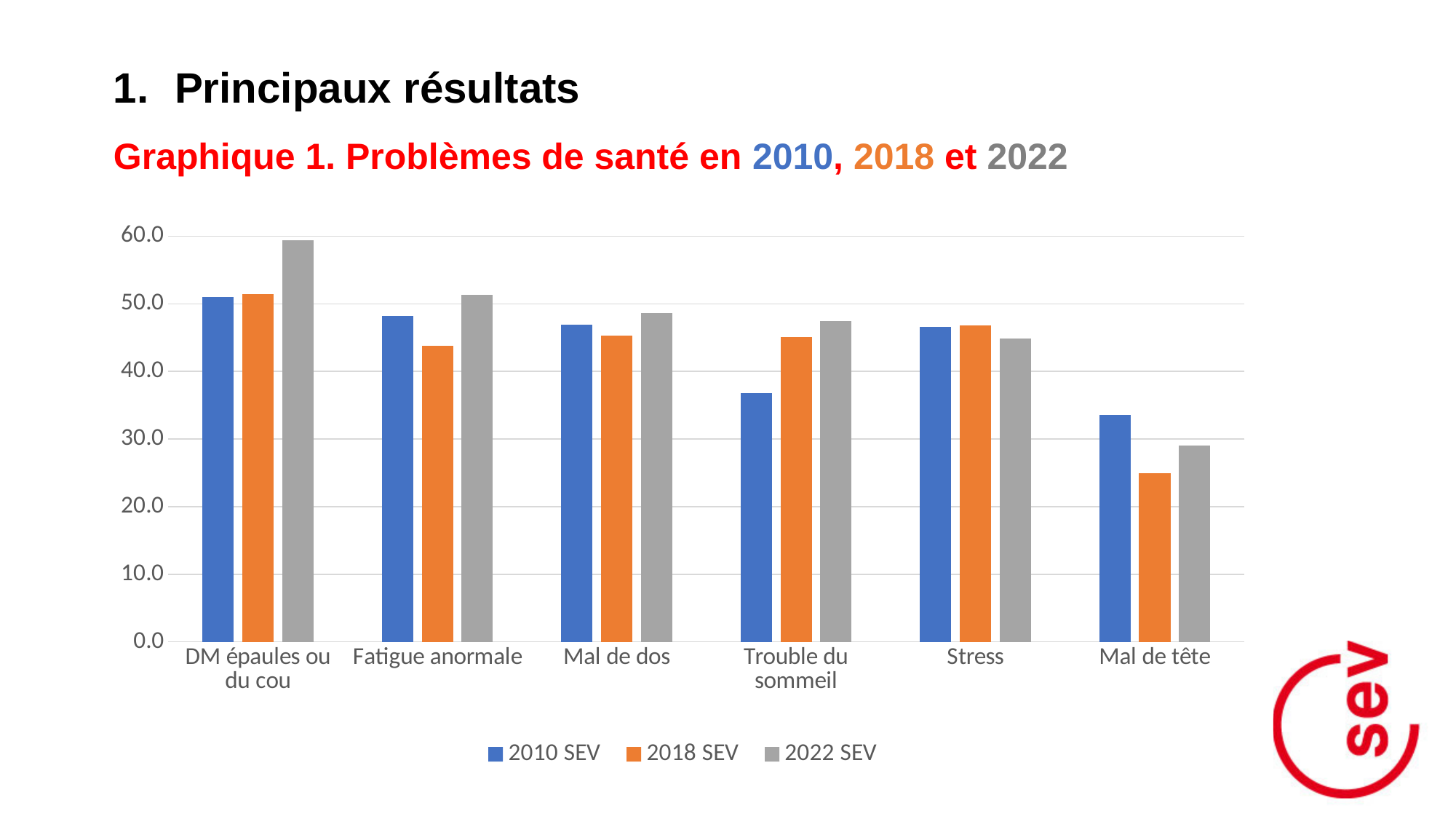
Is the 2010 SEV value for Trouble du sommeil greater or less than 40.0? less Which category has the lowest value for the 2010 SEV series? Mal de tête What colour represents the 2018 SEV series in the chart? orange Is the 2022 SEV value for DM épaules ou du cou greater or less than 50.0? greater How many health problem categories are shown on the x axis? 6 Which category has the highest value for the 2022 SEV series? DM épaules ou du cou What kind of chart is shown on the slide? bar chart How many series does the legend list? 3 Is the 2018 SEV value for Mal de tête greater or less than 30.0? less For Trouble du sommeil, which is larger: the 2010 SEV value or the 2022 SEV value? 2022 SEV Which category has the lowest value for the 2018 SEV series? Mal de tête For Fatigue anormale, which is larger: the 2018 SEV value or the 2022 SEV value? 2022 SEV